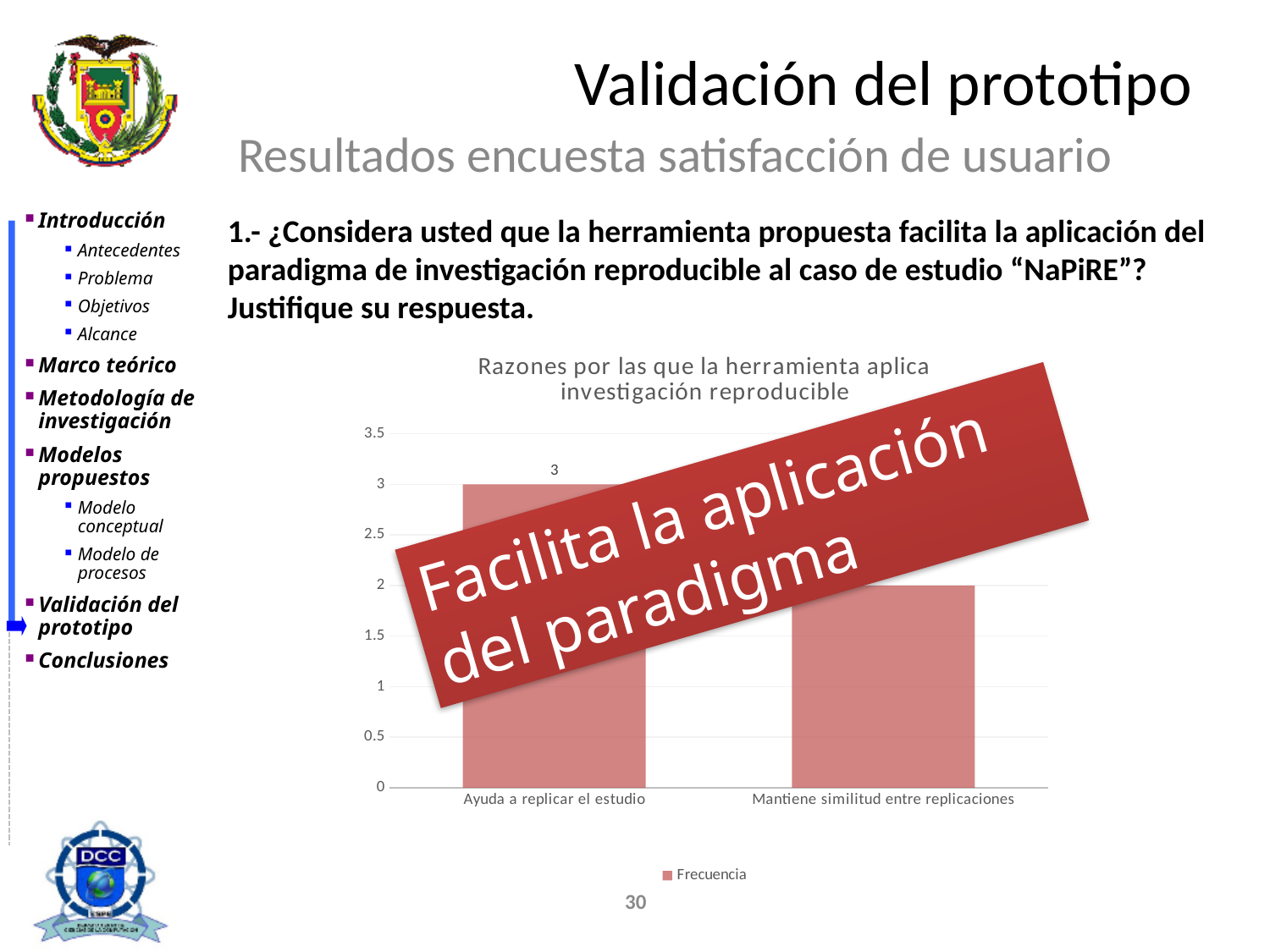
Is the value for 'Mantiene similitud entre replicaciones' greater or less than 2.5? less What is the title of the chart? Razones por las que la herramienta aplica investigación reproducible Which is larger: the value for 'Ayuda a replicar el estudio' or for 'Mantiene similitud entre replicaciones'? Ayuda a replicar el estudio What type of chart is shown on the slide? bar chart What is the value for 'Ayuda a replicar el estudio'? 3 What series name appears in the chart legend? Frecuencia How many categories are shown on the x axis of the chart? 2 What is the value for 'Mantiene similitud entre replicaciones'? 2 What is the difference between the values for 'Ayuda a replicar el estudio' and 'Mantiene similitud entre replicaciones'? 1 Which category has the lowest value? Mantiene similitud entre replicaciones How many series does the chart legend list? 1 Which category has the highest value? Ayuda a replicar el estudio